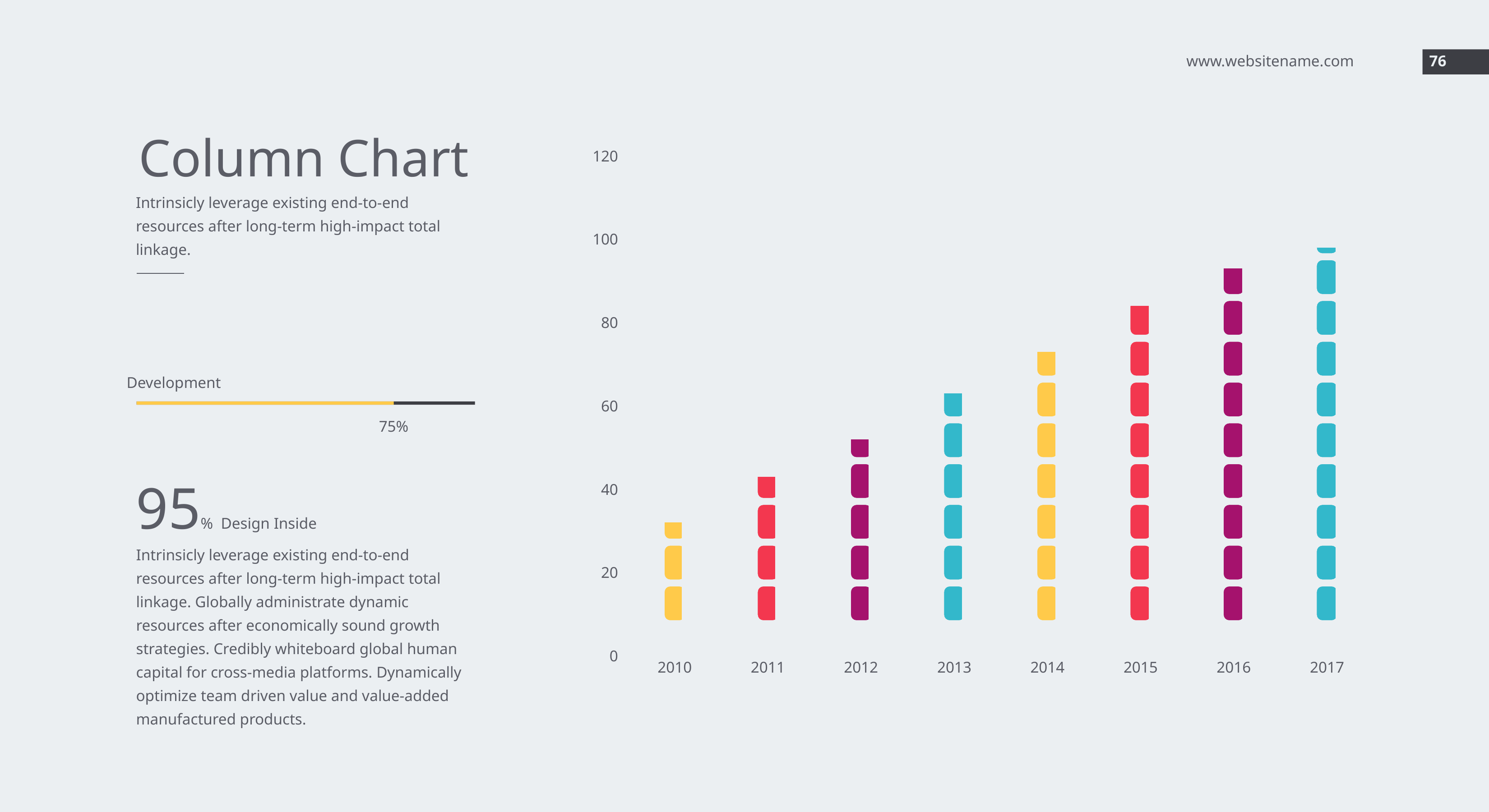
What kind of chart is shown on the slide? bar chart Which is larger, the value for 2013 or the value for 2015? 2015 Which year has the highest bar in the chart? 2017 What is the title shown on the slide for the chart? Column Chart Is the value for 2016 greater or less than 80? greater Is the value for 2012 greater or less than 40? greater Is the value for 2010 greater or less than 40? less Which year has the lowest bar in the chart? 2010 Do the bar values rise or fall from 2010 to 2017? rise How many years are shown on the x axis of the chart? 8